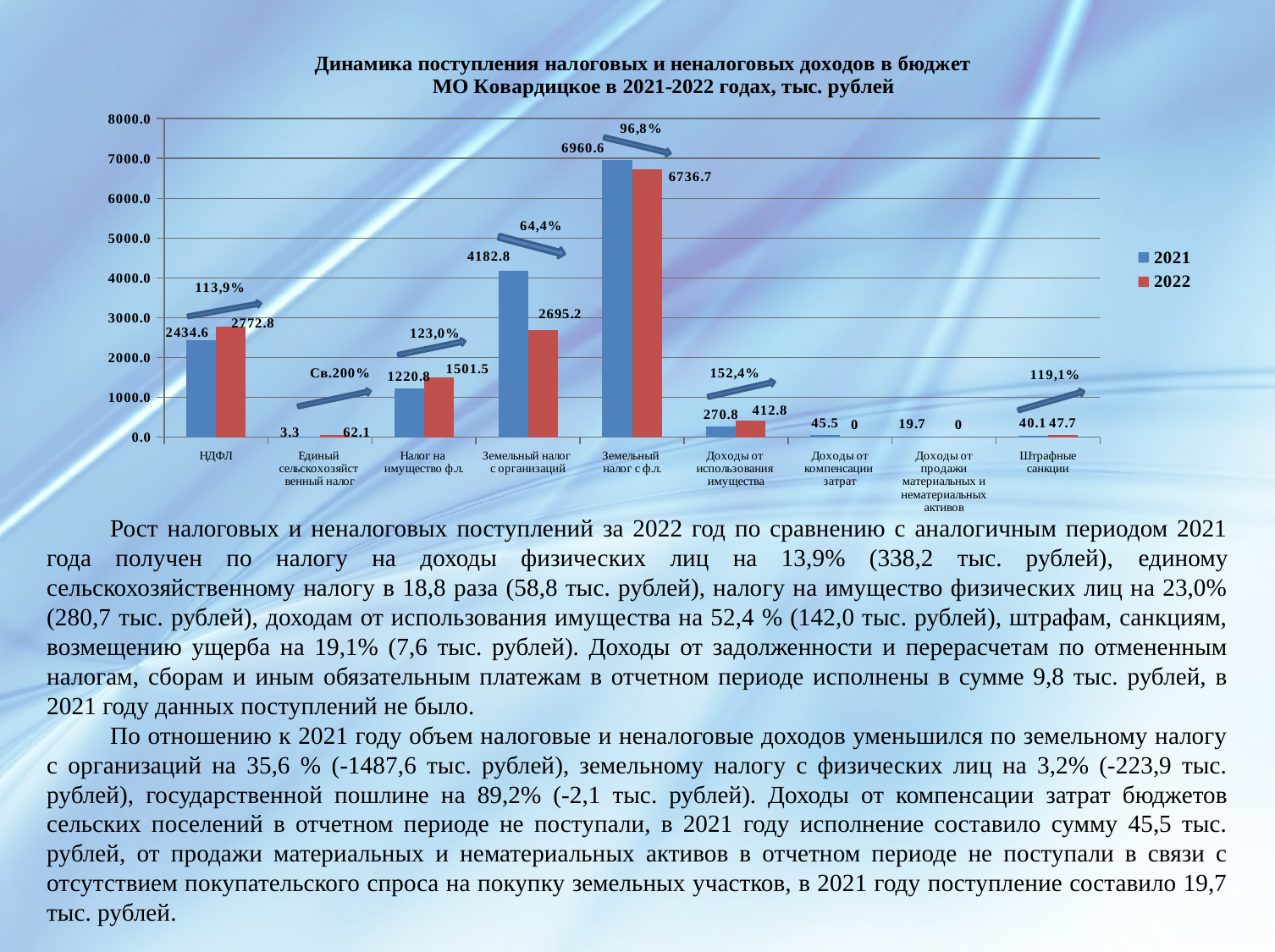
What is the 2021 value for НДФЛ? 2434.6 Is the 2022 value for Земельный налог с ф.л. greater or less than 6000.0? greater What is the 2022 value for Земельный налог с организаций? 2695.2 What is the 2022 value for Доходы от компенсации затрат? 0 Which category has the highest 2021 value? Земельный налог с ф.л. How many categories are shown on the x axis? 9 What kind of chart is shown on the slide? bar chart How many series does the legend list? 2 Which category has the lowest 2021 value? Единый сельскохозяйственный налог What is the 2022 value for Доходы от использования имущества? 412.8 What is the difference between the 2021 and 2022 values for Земельный налог с организаций? 1487.6 Which is larger for Налог на имущество ф.л.: the 2021 value or the 2022 value? 2022